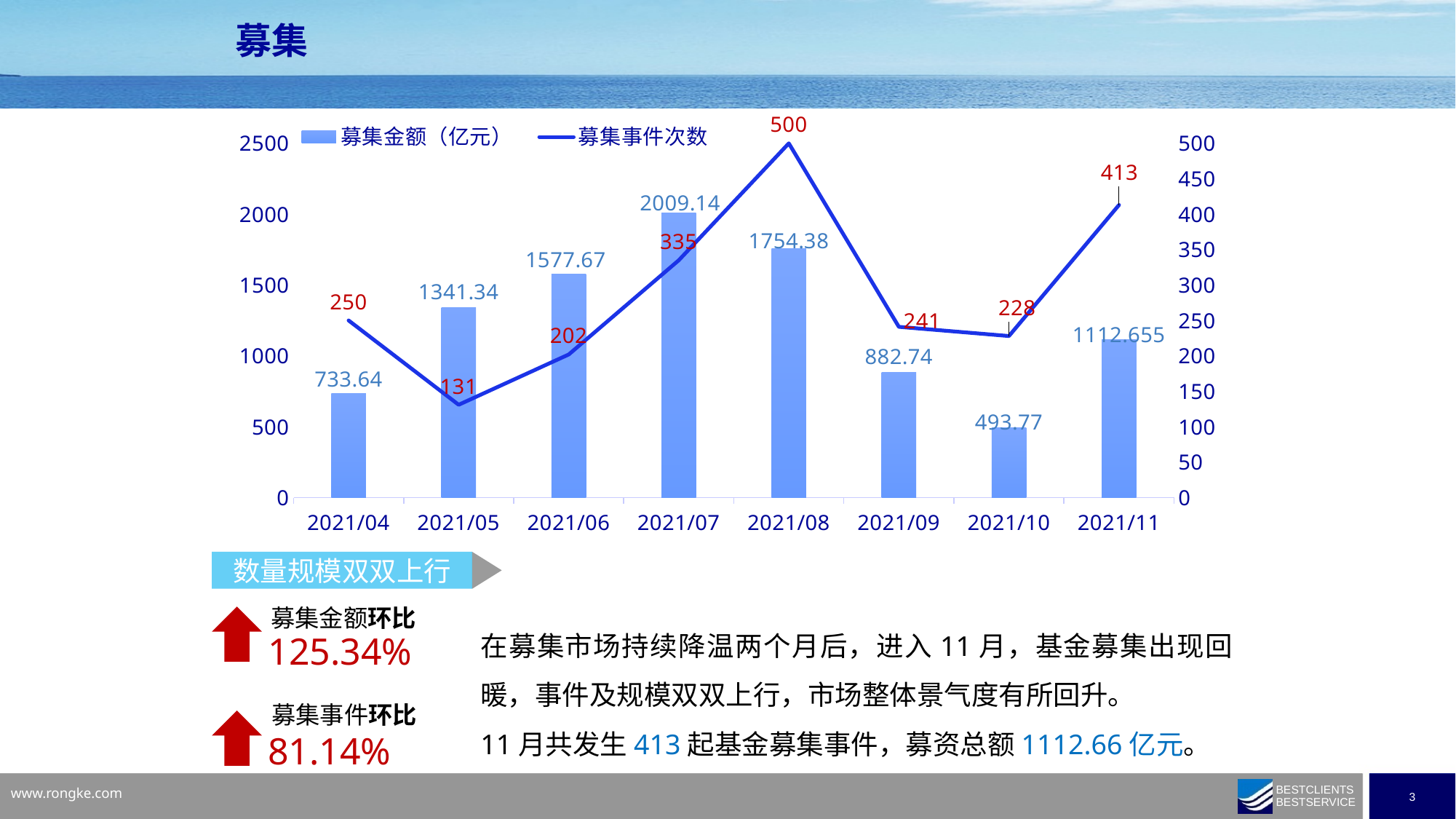
What is the 募集金额（亿元） value for 2021/07? 2009.14 Which month has the lowest 募集事件次数? 2021/05 How many months are shown on the x axis? 8 Which is larger, the 募集金额（亿元） for 2021/05 or for 2021/09? 2021/05 Which month has the lowest 募集金额（亿元）? 2021/10 What is the 募集事件次数 value for 2021/08? 500 What is the difference in 募集事件次数 between 2021/11 and 2021/10? 185 What is the 募集金额（亿元） value for 2021/11? 1112.655 What kind of chart is shown on the slide? Combined bar and line chart Which month has the highest 募集事件次数? 2021/08 Does the 募集金额（亿元） rise or fall from 2021/04 to 2021/07? Rise How many series does the legend list? 2